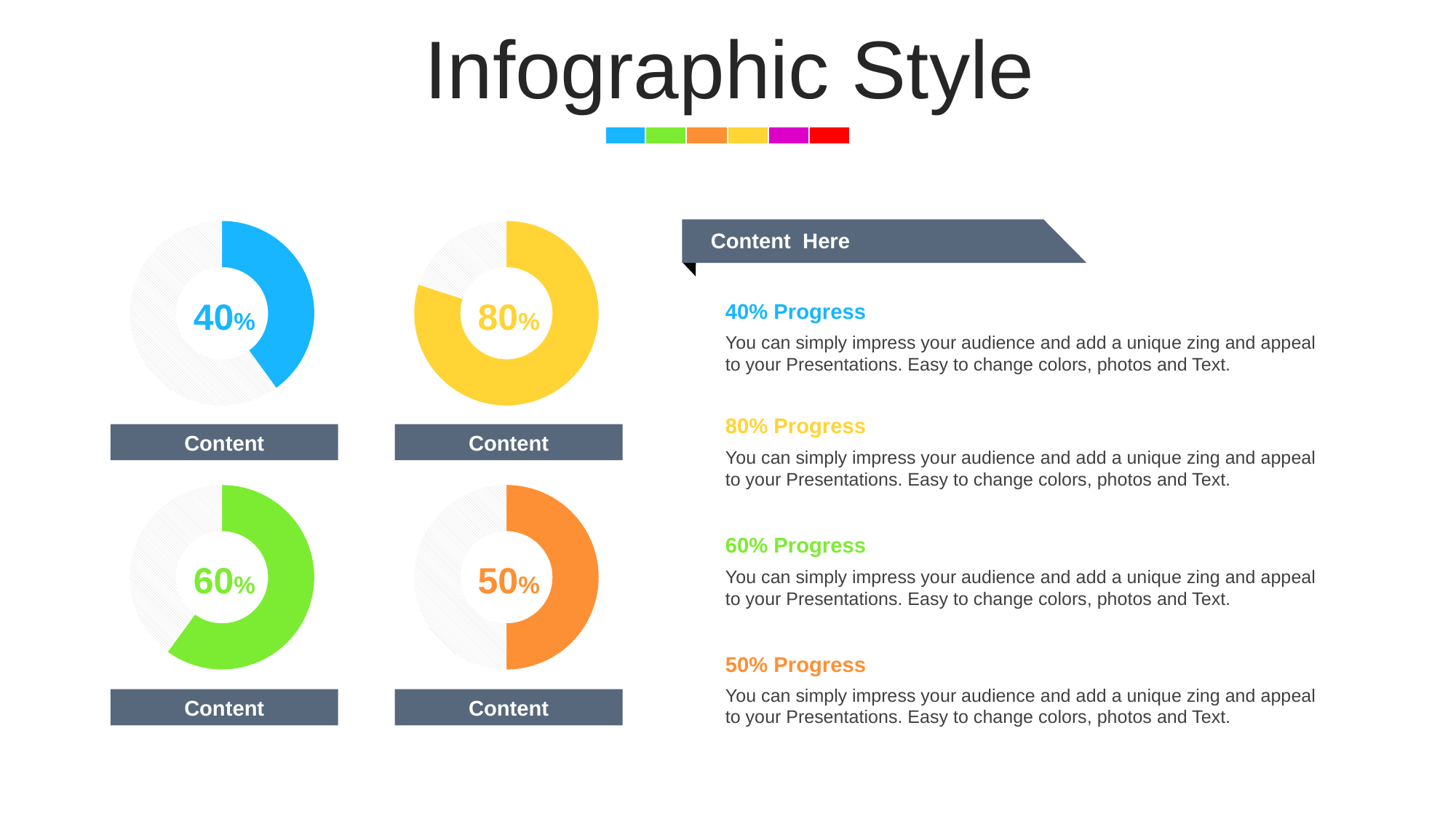
What label appears in the bar beneath each doughnut chart? Content What kind of chart is used to show the percentages on the left side of the slide? Doughnut chart What is the difference between the value in the top-right doughnut chart and the value in the top-left doughnut chart? 40% What value is shown in the centre of the bottom-left doughnut chart? 60% Which of the four doughnut charts shows the highest percentage? The top-right (yellow) chart, 80% What colour is the filled ring of the doughnut chart showing 50%? Orange Which is larger: the value in the bottom-left doughnut chart or the value in the bottom-right doughnut chart? The bottom-left chart (60%) What value is shown in the centre of the bottom-right doughnut chart? 50% Which of the four doughnut charts shows the lowest percentage? The top-left (blue) chart, 40% How many doughnut charts are on the slide? 4 What value is shown in the centre of the top-left doughnut chart? 40% What value is shown in the centre of the top-right doughnut chart? 80%